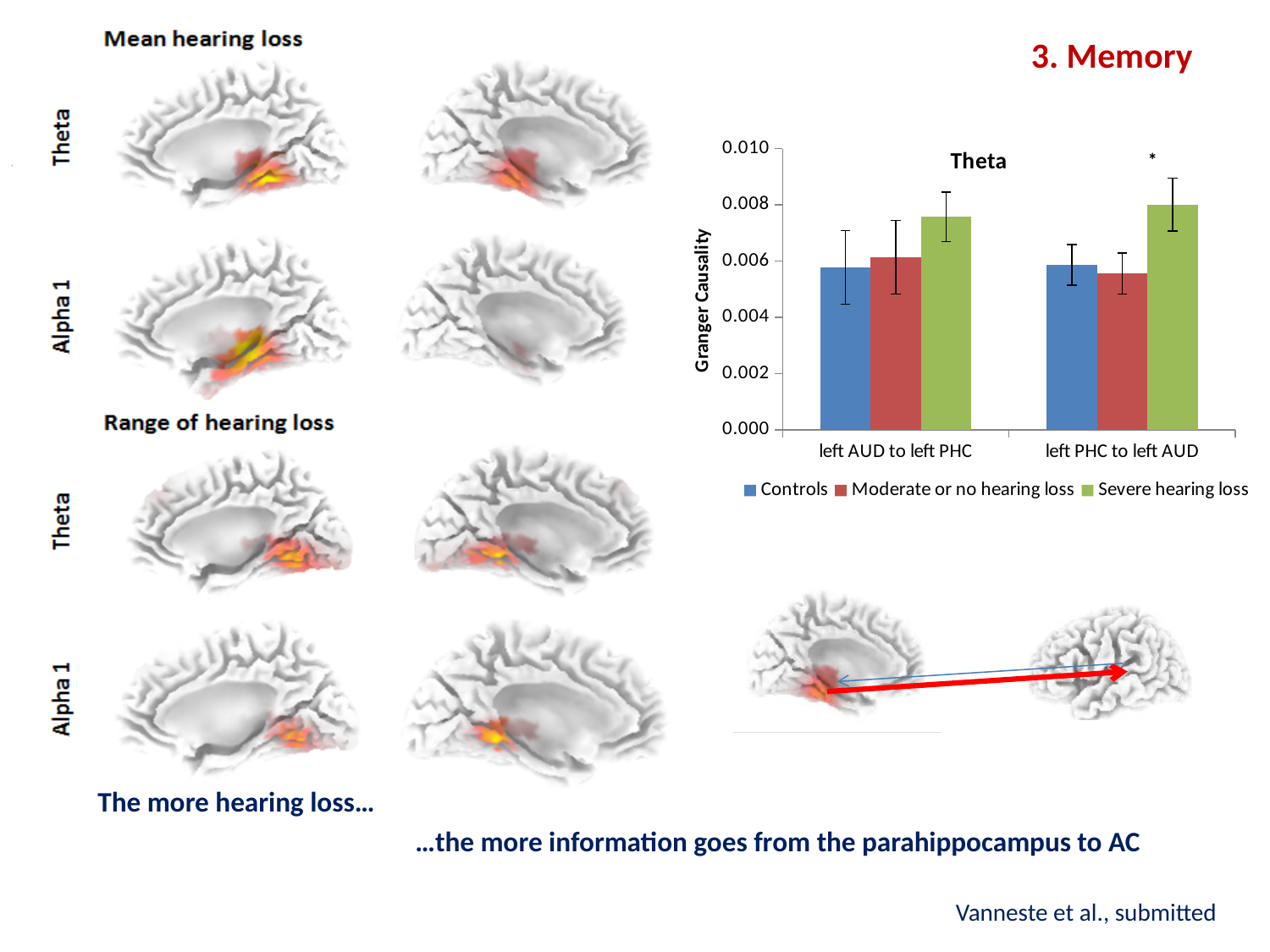
How many series does the chart's legend list? 3 Is the value for Severe hearing loss in left PHC to left AUD greater or less than 0.006? greater For left AUD to left PHC, which is larger: Moderate or no hearing loss or Severe hearing loss? Severe hearing loss How many categories are shown on the x axis of the chart? 2 Which series has the highest value for left AUD to left PHC? Severe hearing loss What is the title of the y axis of the chart? Granger Causality Is the value for Severe hearing loss in left AUD to left PHC greater or less than 0.006? greater What kind of chart is shown on the slide? bar chart For left PHC to left AUD, which is larger: Controls or Severe hearing loss? Severe hearing loss Which frequency band is labelled inside the chart area? Theta Which series has the highest value for left PHC to left AUD? Severe hearing loss Is the value for Controls in left AUD to left PHC greater or less than 0.008? less